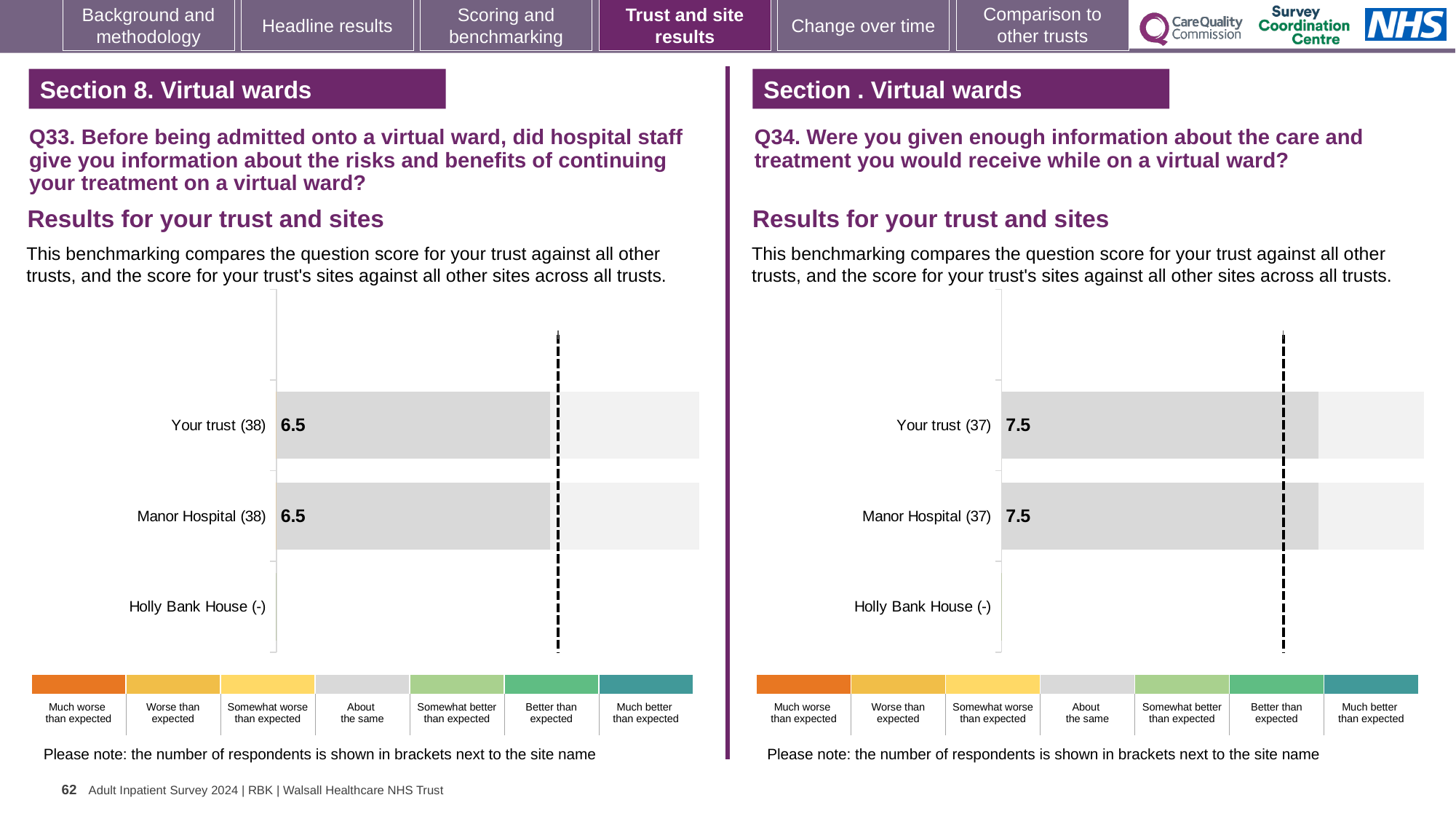
In the Q34 chart on the right, how many respondents are shown in brackets for Your trust? 37 Is the Manor Hospital score in the Q34 chart on the right larger or smaller than the Manor Hospital score in the Q33 chart on the left? Larger In the Q34 chart on the right, what is the score for Manor Hospital? 7.5 How many benchmark bands are shown in the colour legend below the Q33 chart on the left? 7 How many site/trust categories are listed on the y axis of the Q33 chart on the left? 3 In the Q34 chart on the right, what is the score for Your trust? 7.5 In the Q33 chart on the left, how many respondents are shown in brackets for Manor Hospital? 38 In the Q33 chart on the left, what is the score for Your trust? 6.5 In the Q33 chart on the left, what is the difference between the scores for Your trust and Manor Hospital? 0 What kind of chart is used for the Q34 results on the right? Bar chart In the Q33 chart on the left, what is the score for Manor Hospital? 6.5 In the Q34 chart on the right, which category has no score shown? Holly Bank House